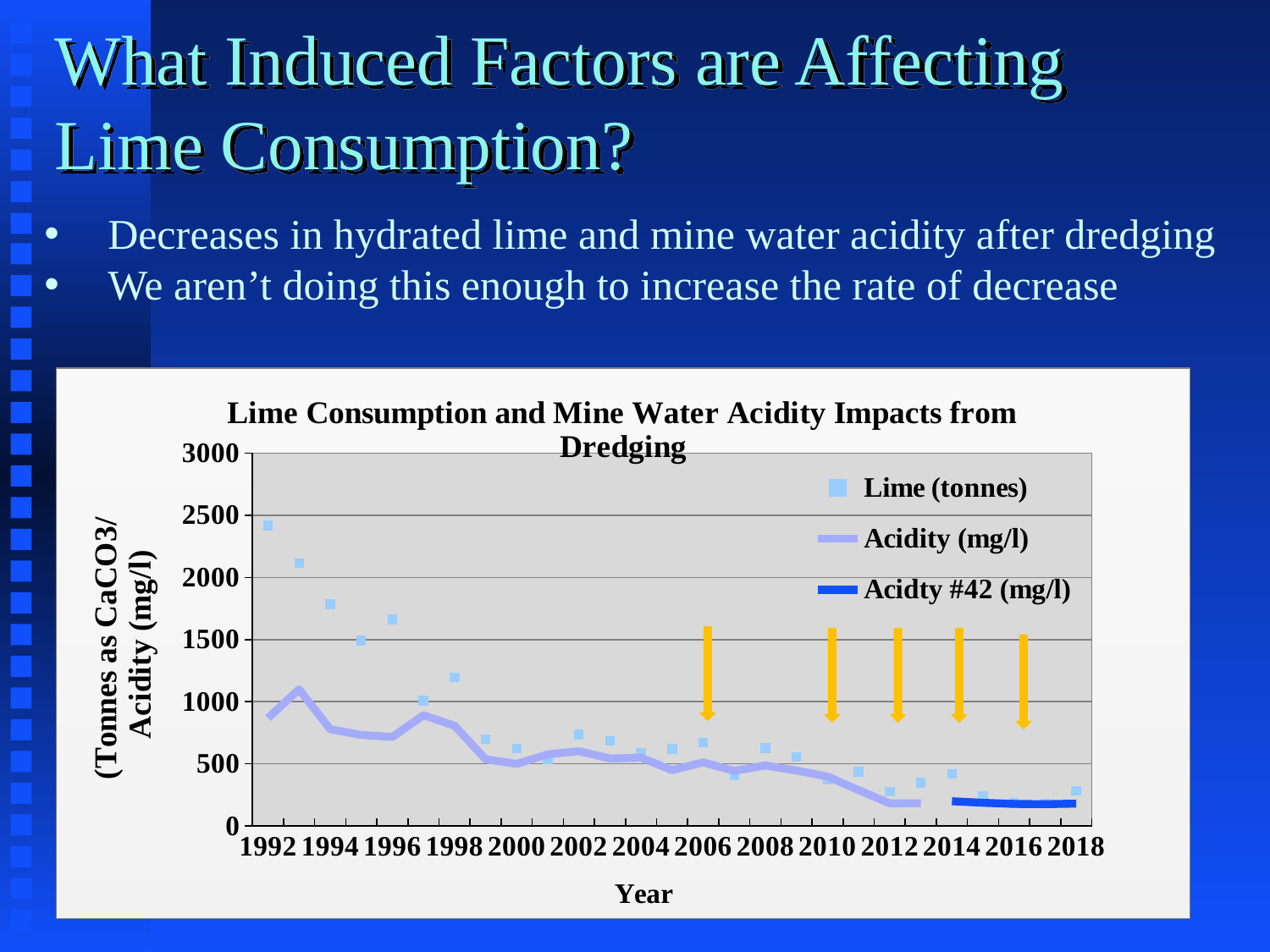
Is the Lime (tonnes) value for 1992 greater or less than 2000? greater Is the Acidity (mg/l) value for 2012 greater or less than 500? less Overall, do the Lime (tonnes) values rise or fall from 1992 to 2018? fall In which year does the Acidity (mg/l) series reach its highest value? 1993 Is the Acidity (mg/l) value for 1993 greater or less than 1000? greater How many series does the chart legend list? 3 In which year is the Lime (tonnes) value highest? 1992 What is the title of the chart? Lime Consumption and Mine Water Acidity Impacts from Dredging What is the x-axis title of the chart? Year Which is larger, the Lime (tonnes) value for 1992 or for 2018? 1992